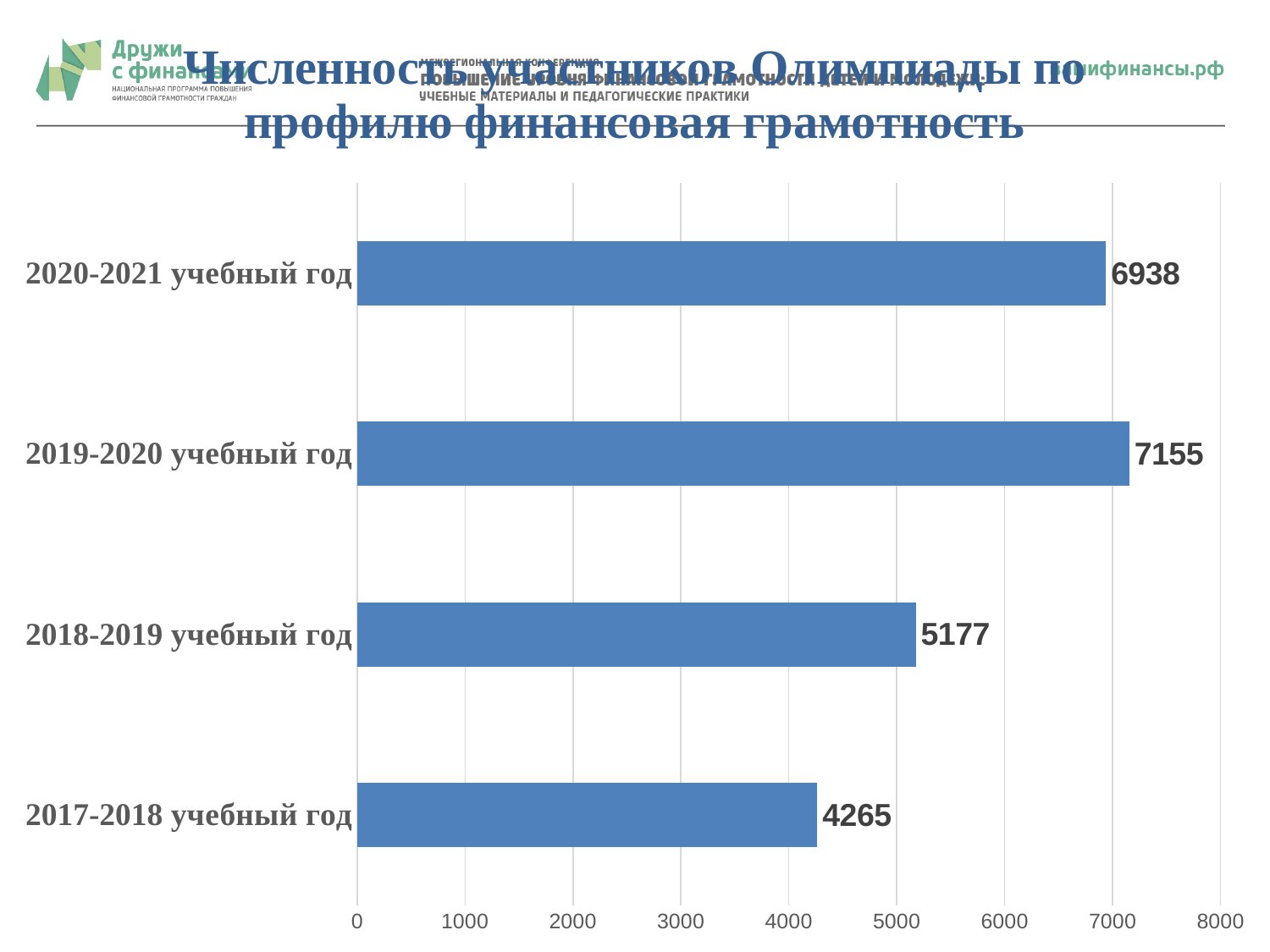
Which academic year has the highest number of participants? 2019-2020 учебный год What is the difference between the values for 2018-2019 and 2017-2018? 912 Which is larger: the value for 2018-2019 or the value for 2020-2021? 2020-2021 учебный год What is the number of participants for the 2017-2018 учебный год? 4265 How many academic years are shown in the chart? 4 What is the difference between the values for 2019-2020 and 2020-2021? 217 What is the number of participants for the 2020-2021 учебный год? 6938 What is the maximum value shown on the horizontal axis? 8000 What is the value shown for the 2018-2019 учебный год? 5177 What kind of chart is shown on the slide? bar chart Is the value for 2019-2020 учебный год greater or less than 7000? greater Which academic year has the lowest number of participants? 2017-2018 учебный год